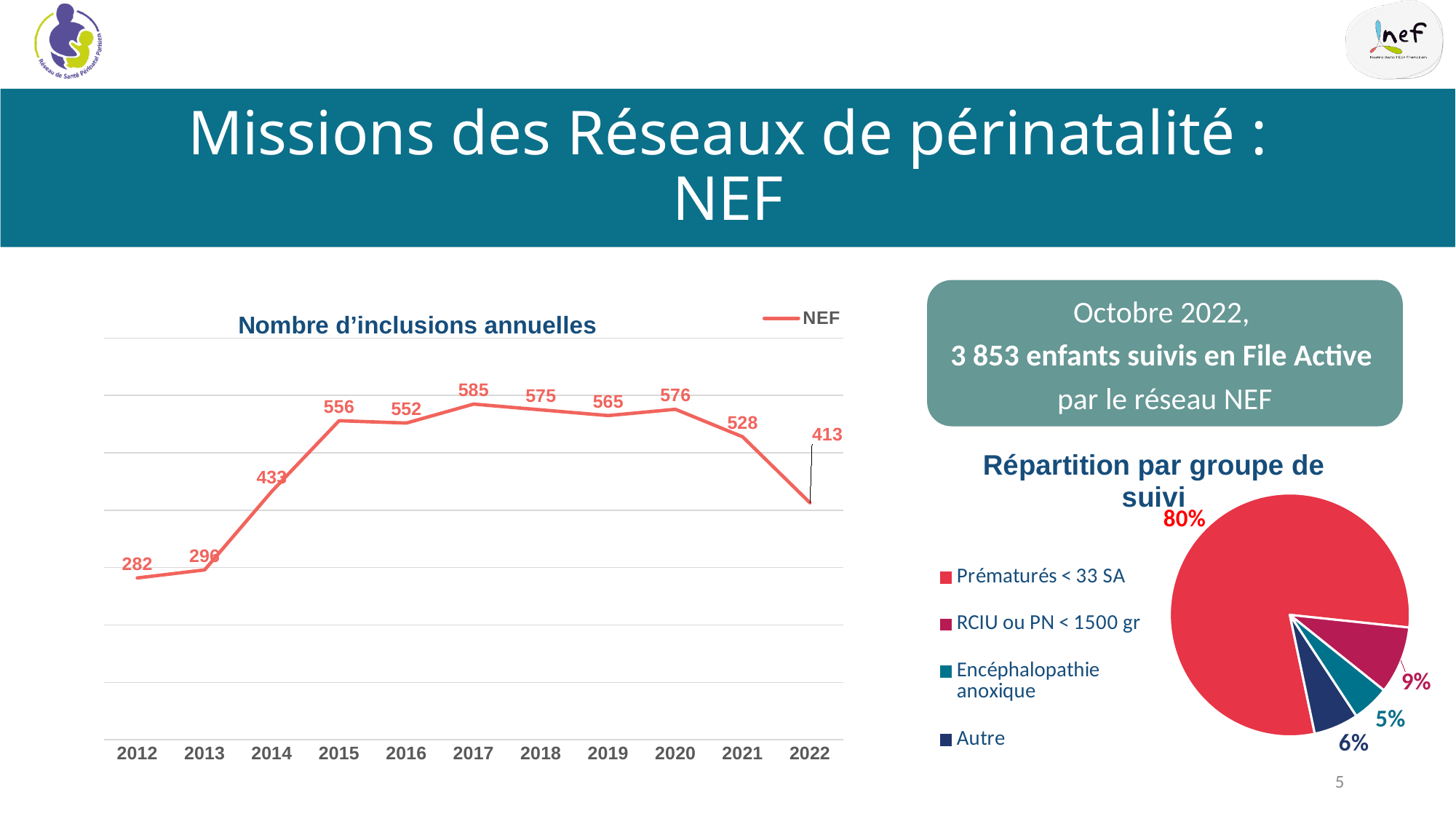
In the chart 'Nombre d'inclusions annuelles', which is larger, the value for 2015 or the value for 2016? 2015 In the chart 'Nombre d'inclusions annuelles', which year has the highest value? 2017 In the pie chart 'Répartition par groupe de suivi', what share is 'Encéphalopathie anoxique'? 5% In the pie chart 'Répartition par groupe de suivi', what share is 'Prématurés < 33 SA'? 80% In the chart 'Nombre d'inclusions annuelles', do the values rise or fall from 2020 to 2022? fall In the chart 'Nombre d'inclusions annuelles', what is the difference between the values for 2021 and 2022? 115 How many categories does the legend of the pie chart 'Répartition par groupe de suivi' list? 4 What kind of chart is 'Nombre d'inclusions annuelles'? line chart In the chart 'Nombre d'inclusions annuelles', what is the value for 2017? 585 In the chart 'Nombre d'inclusions annuelles', what is the value for 2012? 282 How many years are shown on the x axis of the chart 'Nombre d'inclusions annuelles'? 11 In the chart 'Nombre d'inclusions annuelles', which year has the lowest value? 2012